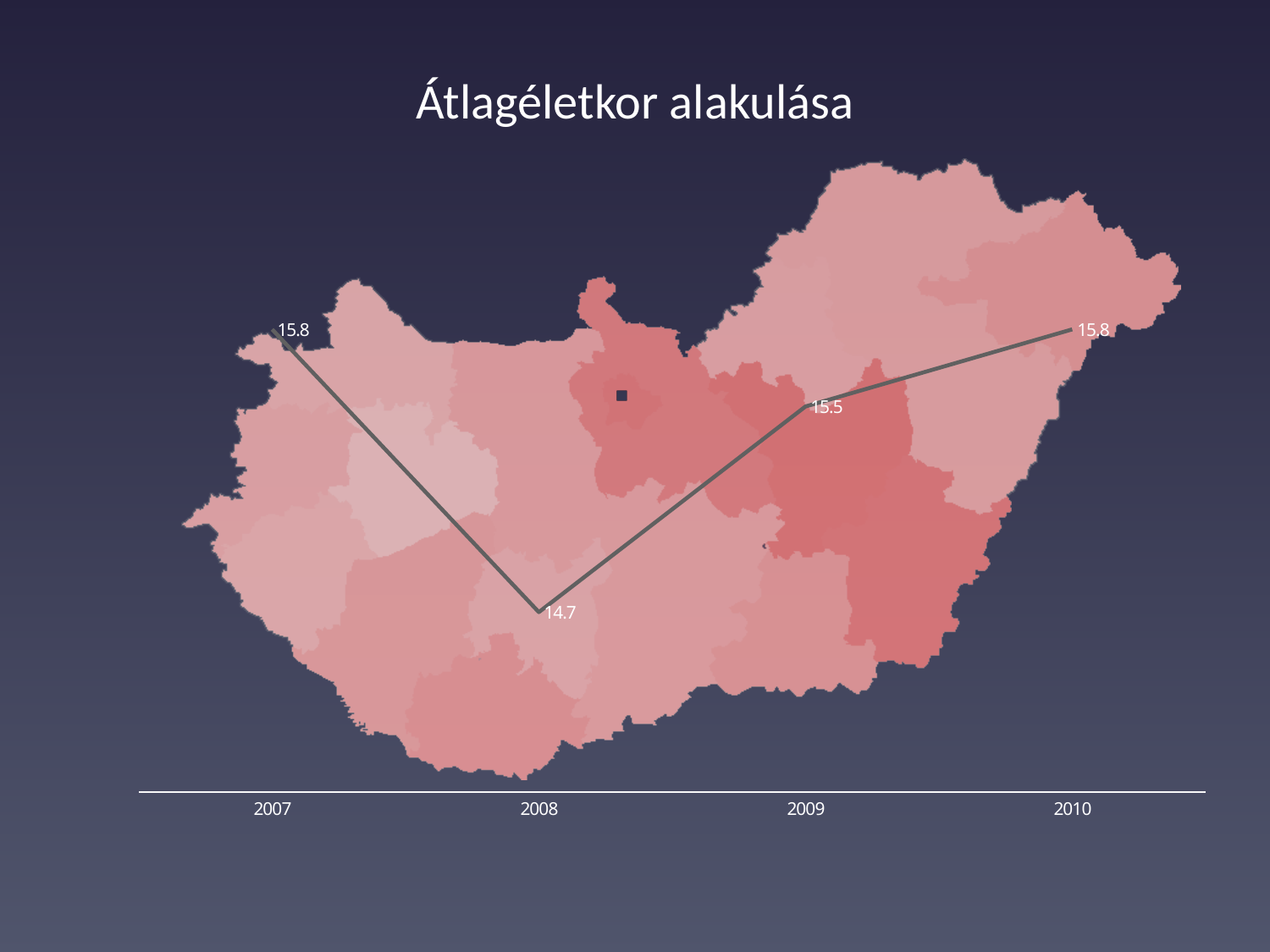
What is the value for 2009? 15.5 What is the value for 2010? 15.8 Which is larger, the value for 2009 or the value for 2010? 2010 What is the value for 2007? 15.8 What is the difference between the values for 2007 and 2008? 1.1 What kind of chart is shown on the slide? line chart How many years are plotted on the x axis? 4 What is the value for 2008? 14.7 Do the values rise or fall from 2008 to 2010? rise What is the difference between the values for 2009 and 2008? 0.8 What is the title of the chart? Átlagéletkor alakulása Which year has the lowest value? 2008